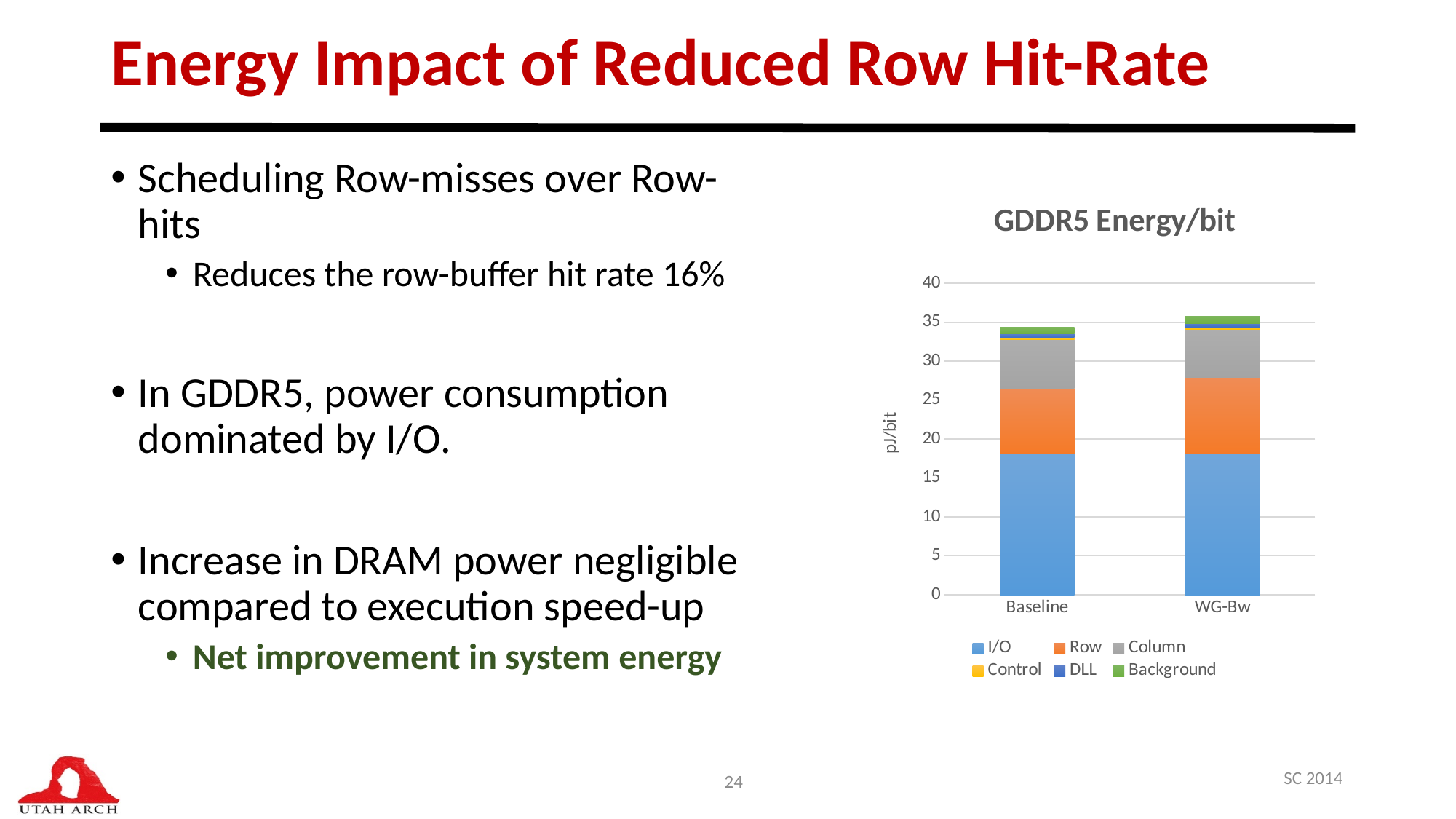
How many series does the chart's legend list? 6 Is the total height of the Baseline stacked bar greater or less than 40? less What kind of chart is shown on the slide? Stacked bar chart Is the I/O value for Baseline greater or less than 15? greater What is the title of the chart? GDDR5 Energy/bit How many categories are shown on the x axis of the chart? 2 Which series forms the largest segment of the Baseline bar? I/O Is the Row segment larger for Baseline or for WG-Bw? WG-Bw Which category has the taller stacked bar overall, Baseline or WG-Bw? WG-Bw What is the label of the y axis of the chart? pJ/bit Is the total height of the WG-Bw stacked bar greater or less than 30? greater